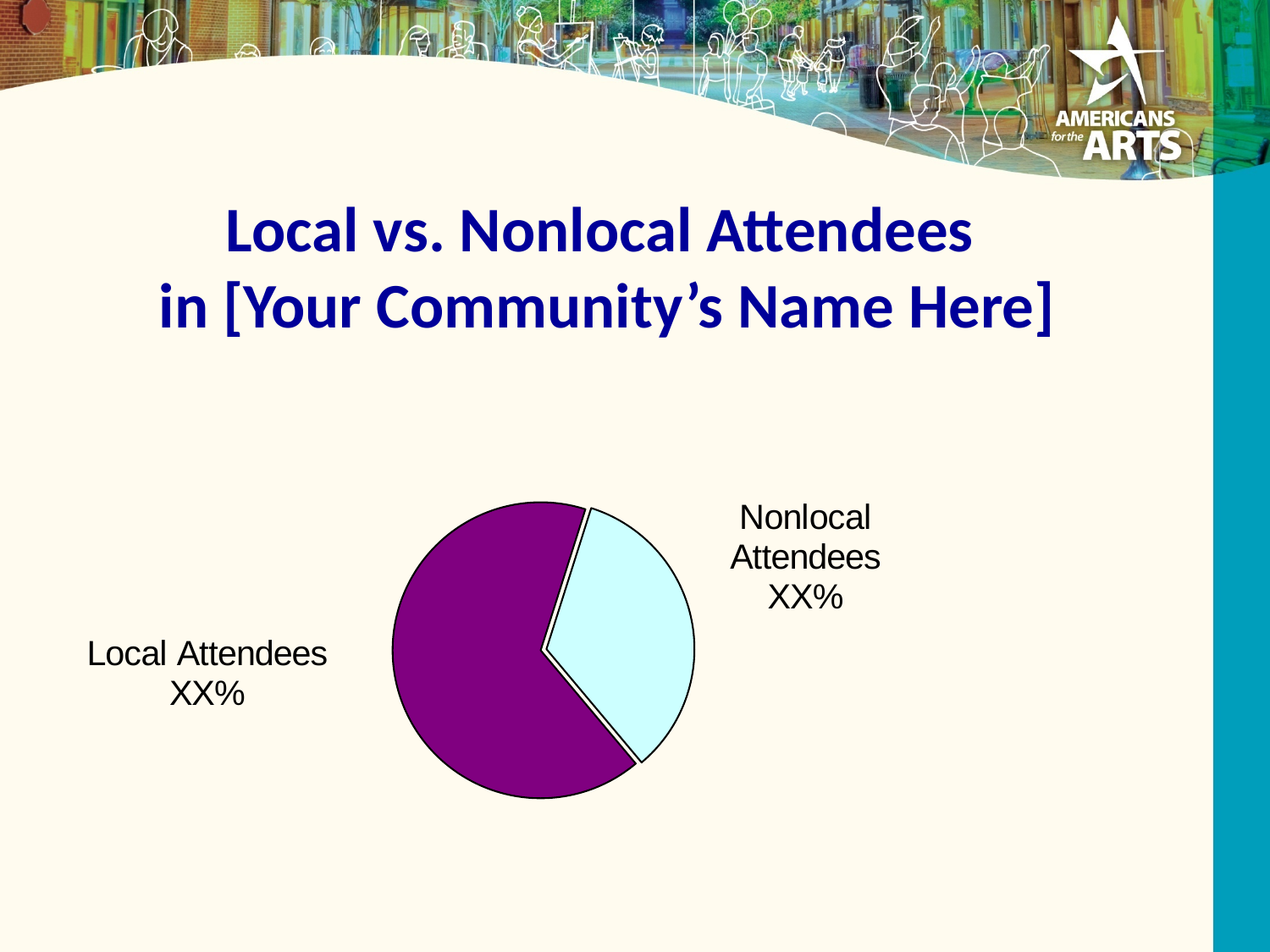
What is the title of the slide containing the pie chart? Local vs. Nonlocal Attendees in [Your Community's Name Here] What kind of chart is shown on the slide? pie chart Does the Local Attendees slice take up more or less than half of the pie? more Which slice of the pie chart is the smallest? Nonlocal Attendees Which slice is larger, Local Attendees or Nonlocal Attendees? Local Attendees What colour is the Local Attendees slice of the pie chart? purple What placeholder text is shown as the percentage label for the Nonlocal Attendees slice? XX% Which slice of the pie chart is the largest? Local Attendees Does the Nonlocal Attendees slice take up more or less than half of the pie? less How many slices does the pie chart have? 2